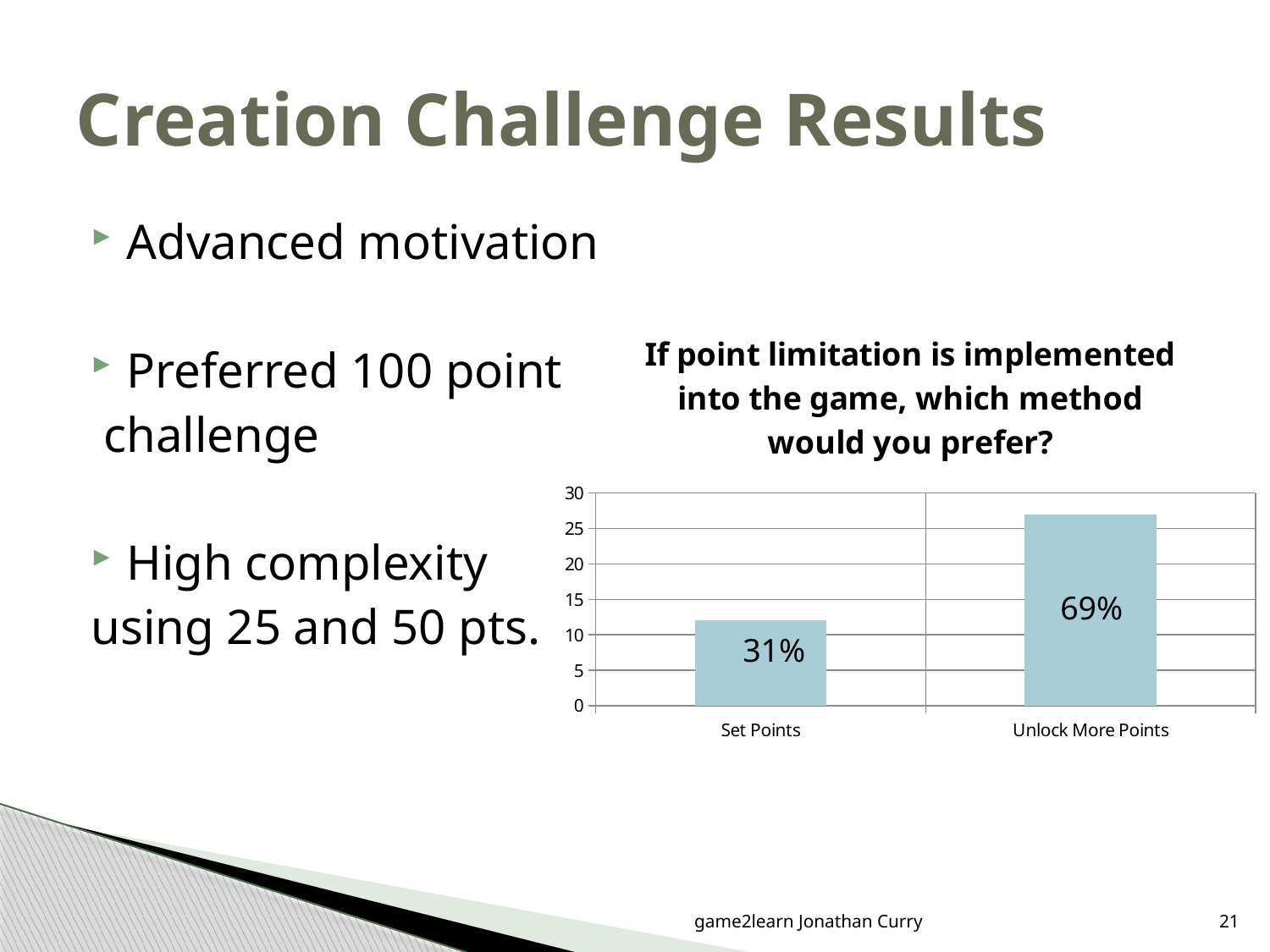
Which category has the highest bar? Unlock More Points What is the data label shown on the Unlock More Points bar? 69% Which is larger, the value for Set Points or the value for Unlock More Points? Unlock More Points What is the data label shown on the Set Points bar? 31% Is the value for Set Points greater or less than 10? greater Is the value for Unlock More Points greater or less than 25? greater What is the title of the chart? If point limitation is implemented into the game, which method would you prefer? What is the difference between the percentage labels for Unlock More Points and Set Points? 38% Is the value for Set Points greater or less than 15? less What kind of chart is shown on the slide? bar chart Which category has the lowest bar? Set Points How many categories are shown on the x axis of the chart? 2